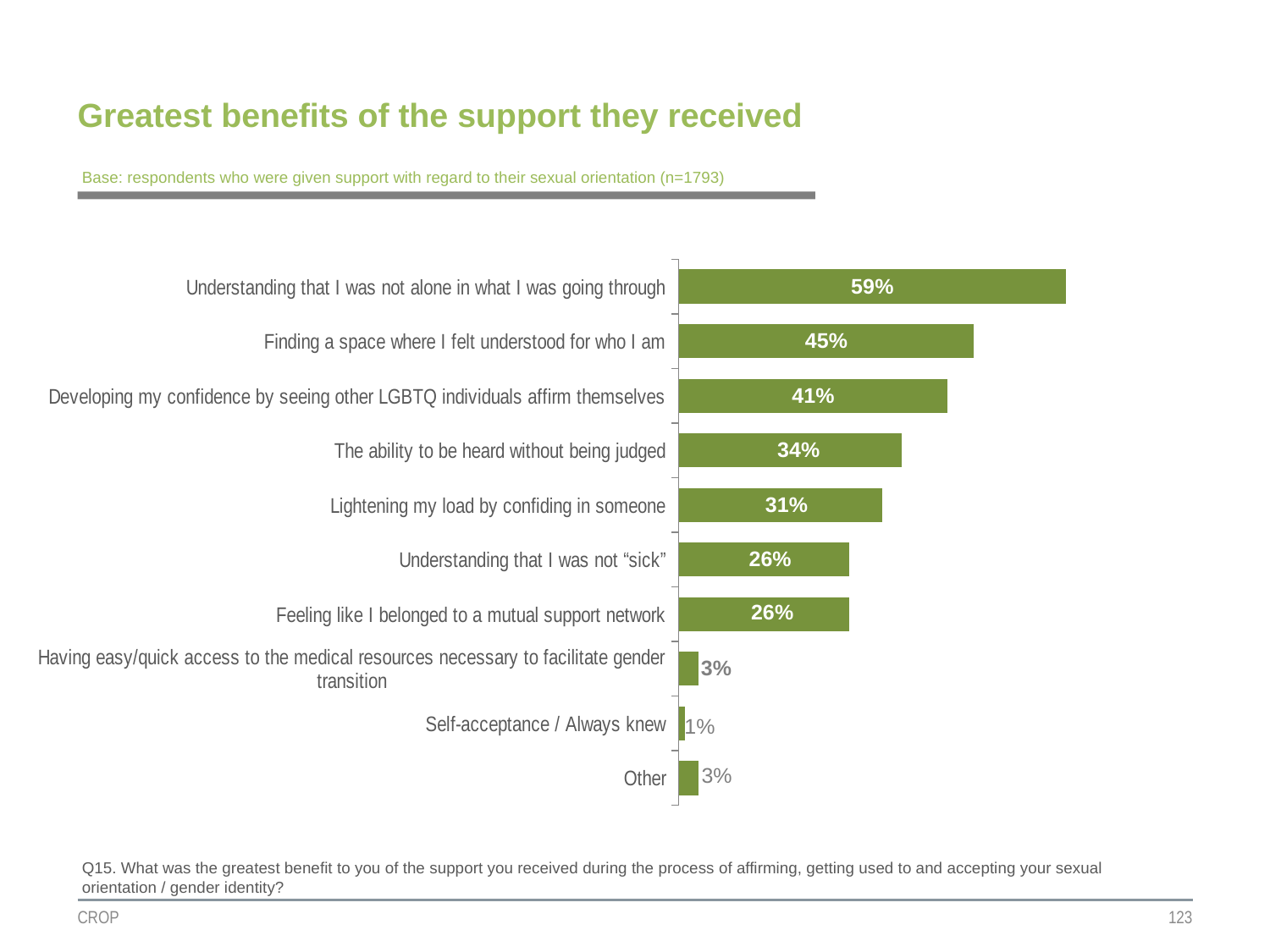
What is the base size (n) stated for the chart? n=1793 What kind of chart is shown on the slide? Bar chart What percentage of respondents cited "Understanding that I was not alone in what I was going through" as the greatest benefit? 59% Which category has the highest value? Understanding that I was not alone in what I was going through What is the value for "The ability to be heard without being judged"? 34% What is the title of the chart on the slide? Greatest benefits of the support they received What is the difference between "Finding a space where I felt understood for who I am" and "Developing my confidence by seeing other LGBTQ individuals affirm themselves"? 4% Which is larger: "The ability to be heard without being judged" or "Understanding that I was not "sick""? The ability to be heard without being judged What is the value for "Self-acceptance / Always knew"? 1% Which category has the lowest value? Self-acceptance / Always knew How many categories are shown in the chart? 10 What is the value for "Lightening my load by confiding in someone"? 31%